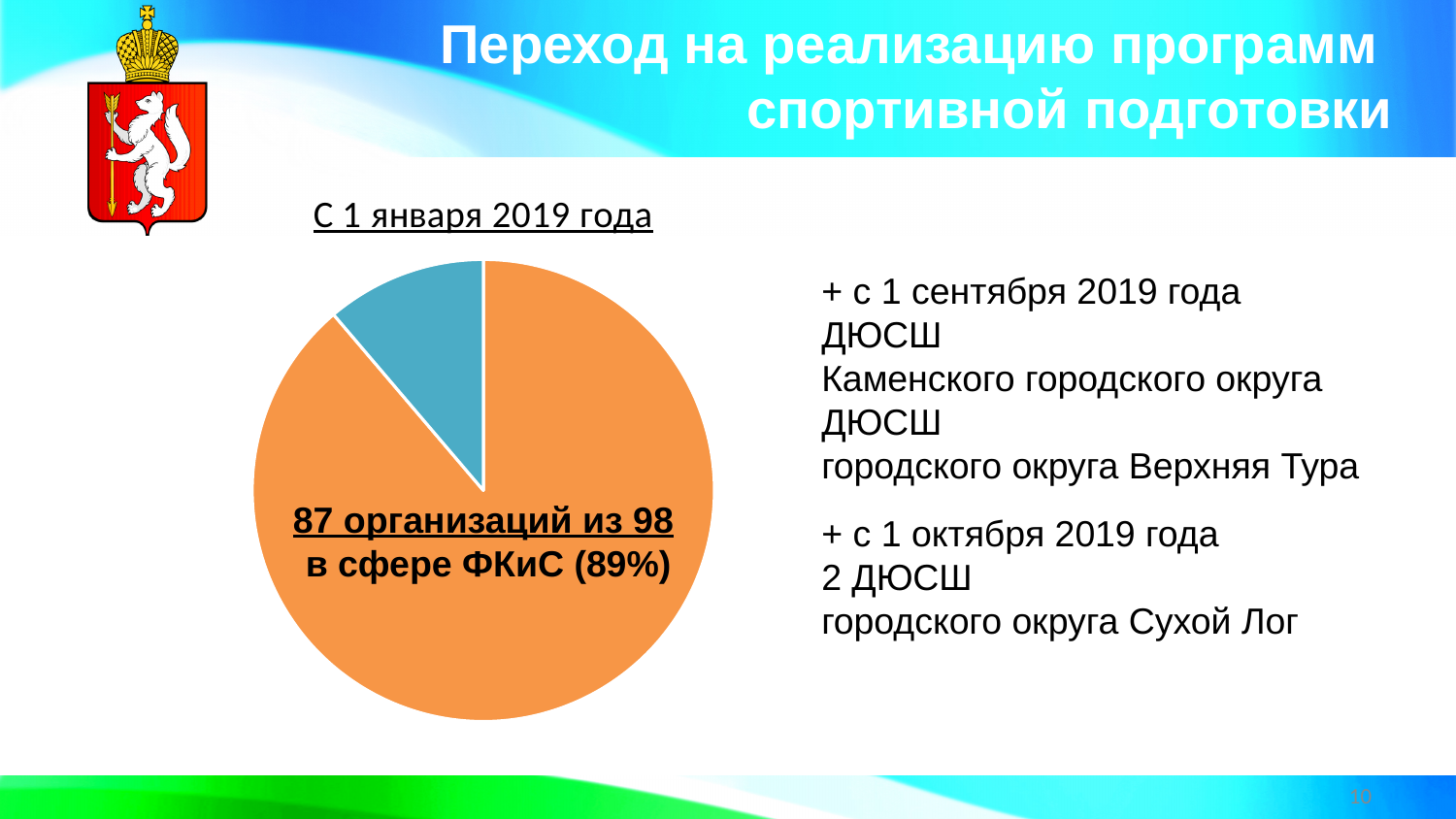
What share of the pie does the blue slice represent, given that the orange slice is 89%? 11% How many organisations does the orange slice of the pie chart represent? 87 How many slices does the pie chart have? 2 What share of the pie does the orange slice represent, according to the label on the chart? 89% Is the orange slice of the pie chart greater or less than 50% of the pie? greater How many organisations are represented by the blue slice, given the chart label '87 организаций из 98'? 11 What is the heading written above the pie chart? С 1 января 2019 года Out of how many organisations in total is the orange slice counted, according to the chart label? 98 What colour is the largest slice of the pie chart? Orange What kind of chart is shown on the slide? Pie chart Which slice of the pie chart is larger, the orange one or the blue one? The orange one